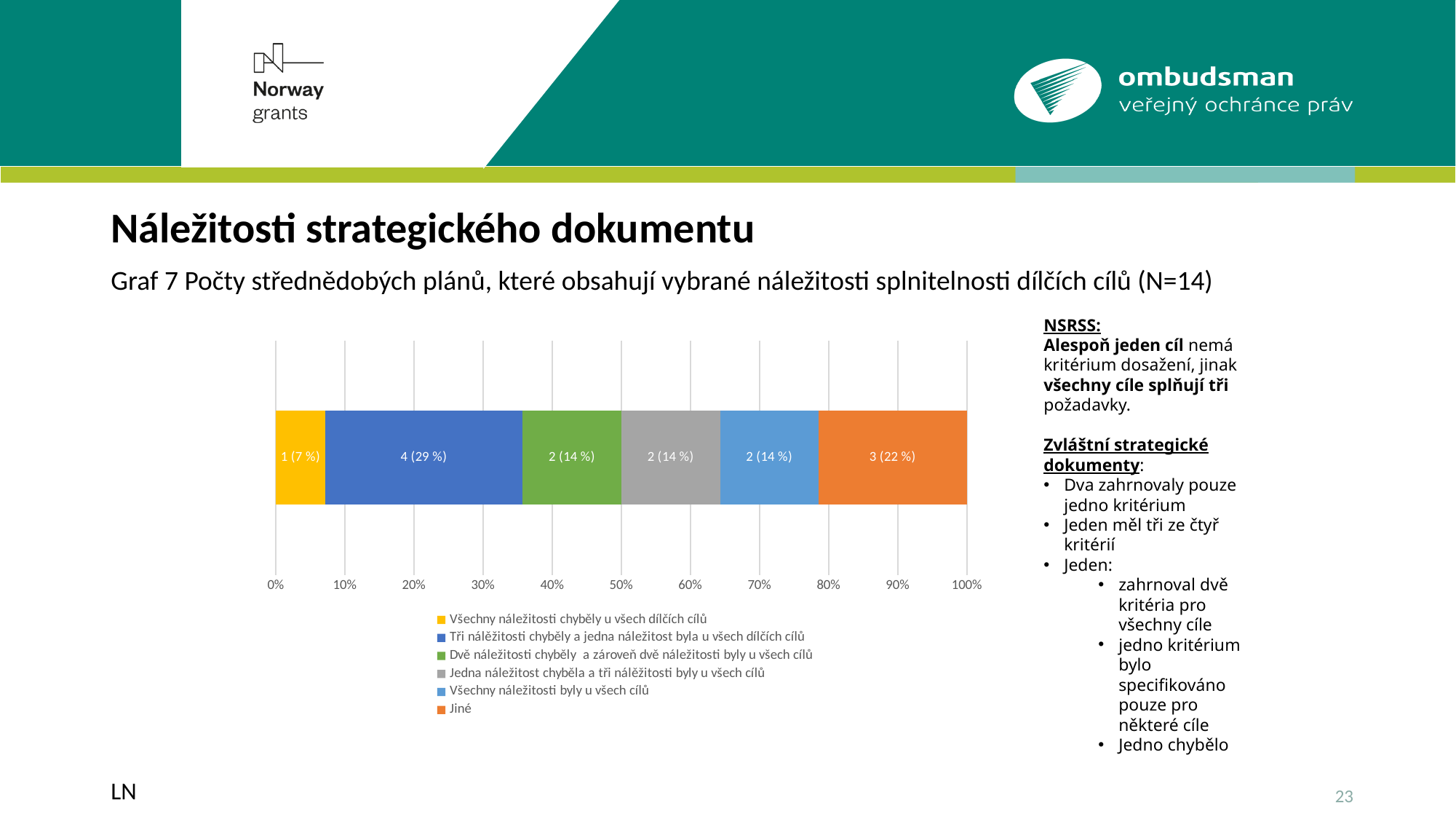
Which series has the largest segment in the bar? Tři náležitosti chyběly a jedna náležitost byla u všech dílčích cílů What colour is the segment for "Jiné"? orange What is the data label for the series "Jiné"? 3 (22 %) How many series does the legend list? 6 How many more plans are in the "Tři náležitosti chyběly a jedna náležitost byla u všech dílčích cílů" segment than in the "Jiné" segment? 1 What is the total number of plans across all segments of the bar? 14 Which is larger: the "Jiné" segment or the "Všechny náležitosti byly u všech cílů" segment? Jiné What is the data label for the series "Všechny náležitosti chyběly u všech dílčích cílů"? 1 (7 %) What is the data label for the series "Všechny náležitosti byly u všech cílů"? 2 (14 %) What is the data label for the series "Tři náležitosti chyběly a jedna náležitost byla u všech dílčích cílů"? 4 (29 %) What kind of chart is shown on the slide? stacked bar chart Which series has the smallest segment in the bar? Všechny náležitosti chyběly u všech dílčích cílů